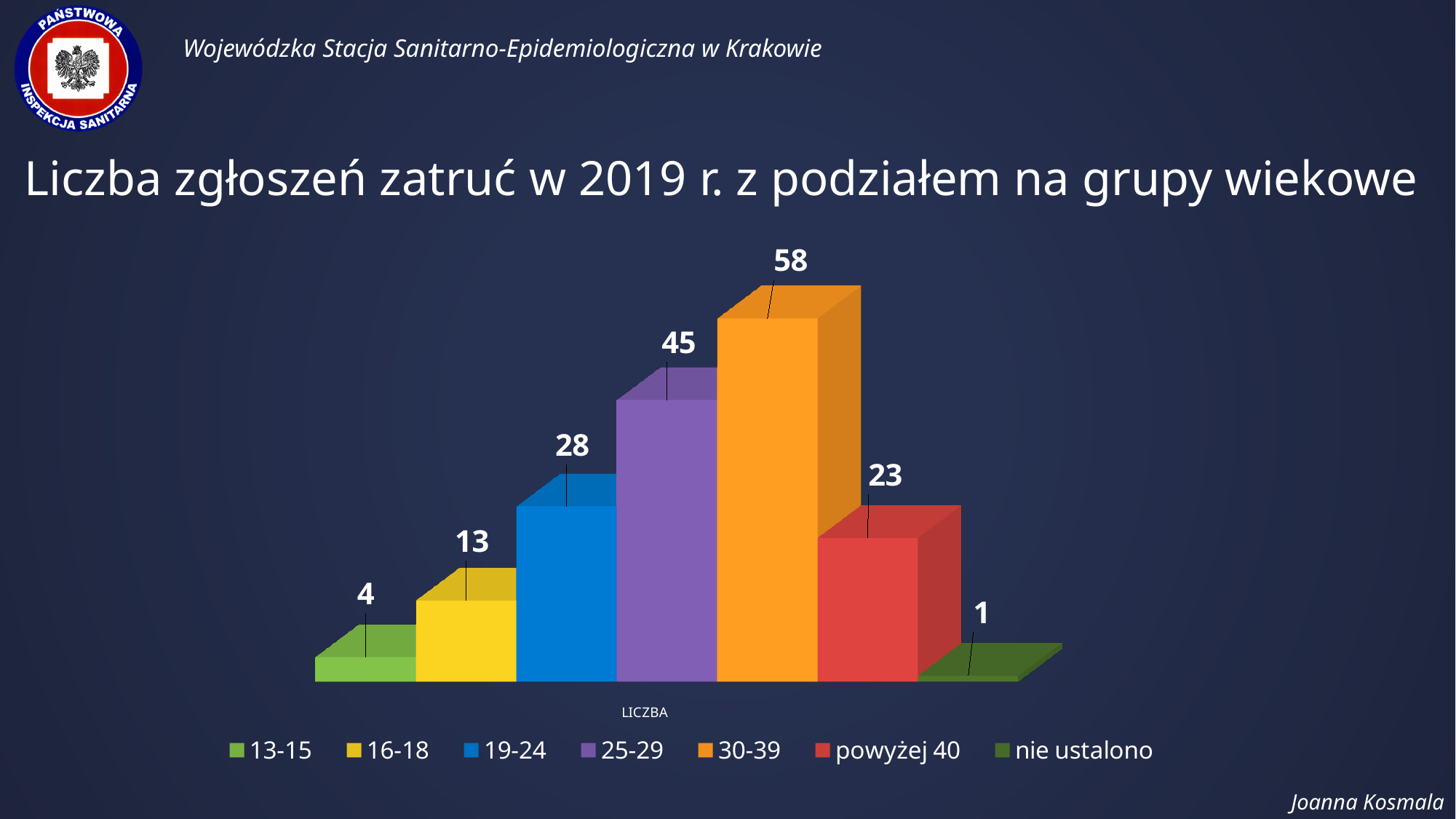
What is the difference between the values for 19-24 and 13-15? 24 Which is larger, the value for 19-24 or the value for powyżej 40? 19-24 What kind of chart is shown on the slide? bar chart What is the value for the 16-18 age group? 13 How many categories are shown in the chart? 7 What is the title of the chart on the slide? Liczba zgłoszeń zatruć w 2019 r. z podziałem na grupy wiekowe Which category has the lowest value? nie ustalono What is the value for the powyżej 40 age group? 23 What is the difference between the values for 30-39 and 25-29? 13 Which age group has the highest value? 30-39 What is the value for the 30-39 age group? 58 How many entries does the legend list? 7